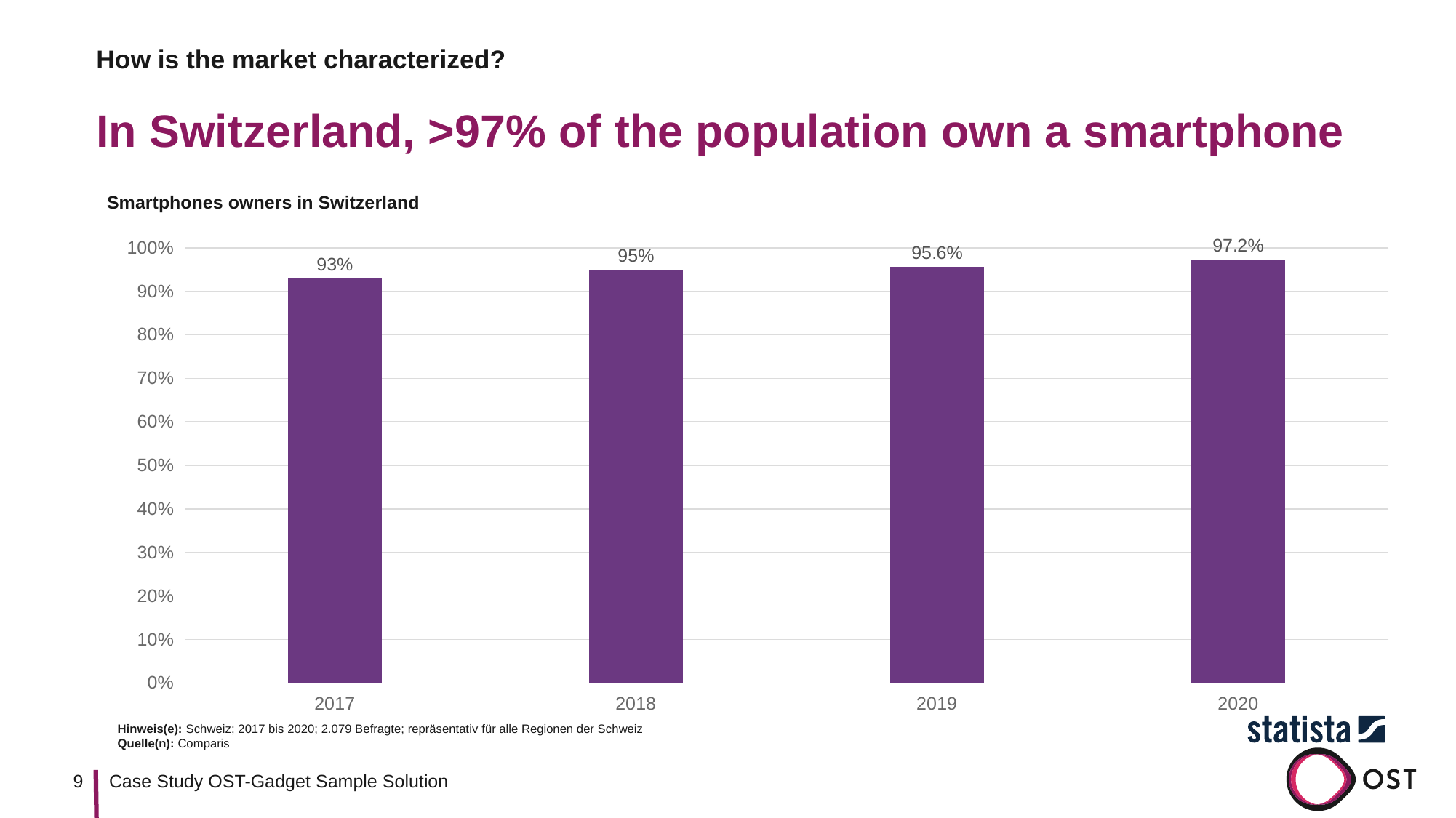
What kind of chart is shown? bar chart Do the values rise or fall from 2017 to 2020? rise What is the difference between the values for 2020 and 2017? 4.2% Which year has the highest share of smartphone owners? 2020 What is the value for 2020? 97.2% What is the value for 2019? 95.6% Which year has the lowest share of smartphone owners? 2017 Is the value for 2019 greater or less than 90%? greater What is the value for 2018? 95% How many years are shown on the x axis? 4 What is the value for 2017? 93% Which is larger, the value for 2018 or the value for 2017? 2018